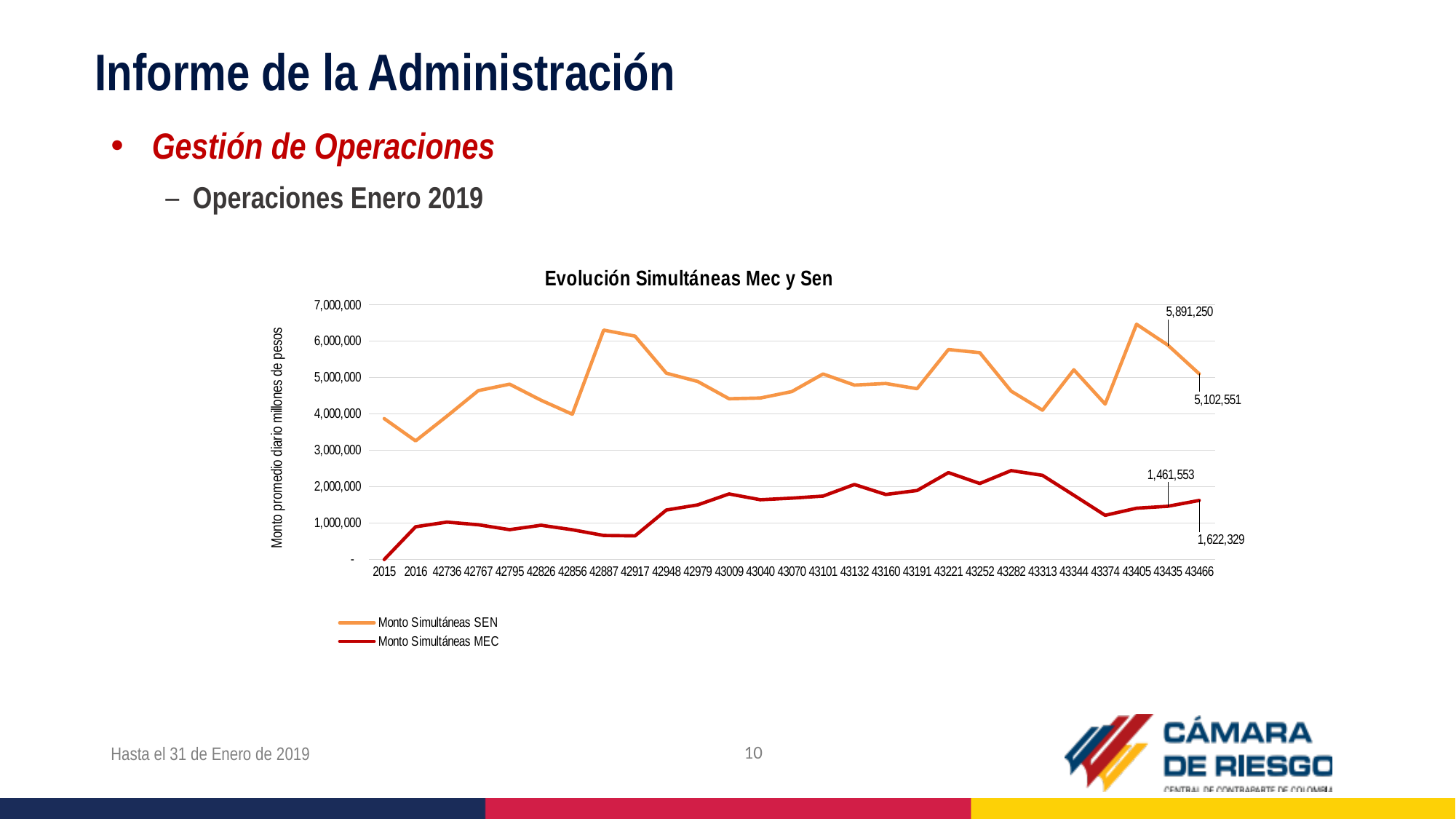
Is the value of Monto Simultáneas SEN at 2016 greater or less than 4,000,000? less How many series does the legend of the chart list? 2 What is the value of Monto Simultáneas SEN at 43466? 5,102,551 At 43466, which series has the larger value, Monto Simultáneas SEN or Monto Simultáneas MEC? Monto Simultáneas SEN What is the value of Monto Simultáneas SEN at 43435? 5,891,250 What is the value of Monto Simultáneas MEC at 43466? 1,622,329 By how much did Monto Simultáneas SEN fall from 43435 to 43466? 788,699 What kind of chart is shown on the slide? line chart What is the value of Monto Simultáneas MEC at 43435? 1,461,553 What is the title of the chart? Evolución Simultáneas Mec y Sen By how much did Monto Simultáneas MEC rise from 43435 to 43466? 160,776 Which x-axis category has the lowest value for Monto Simultáneas SEN? 2016